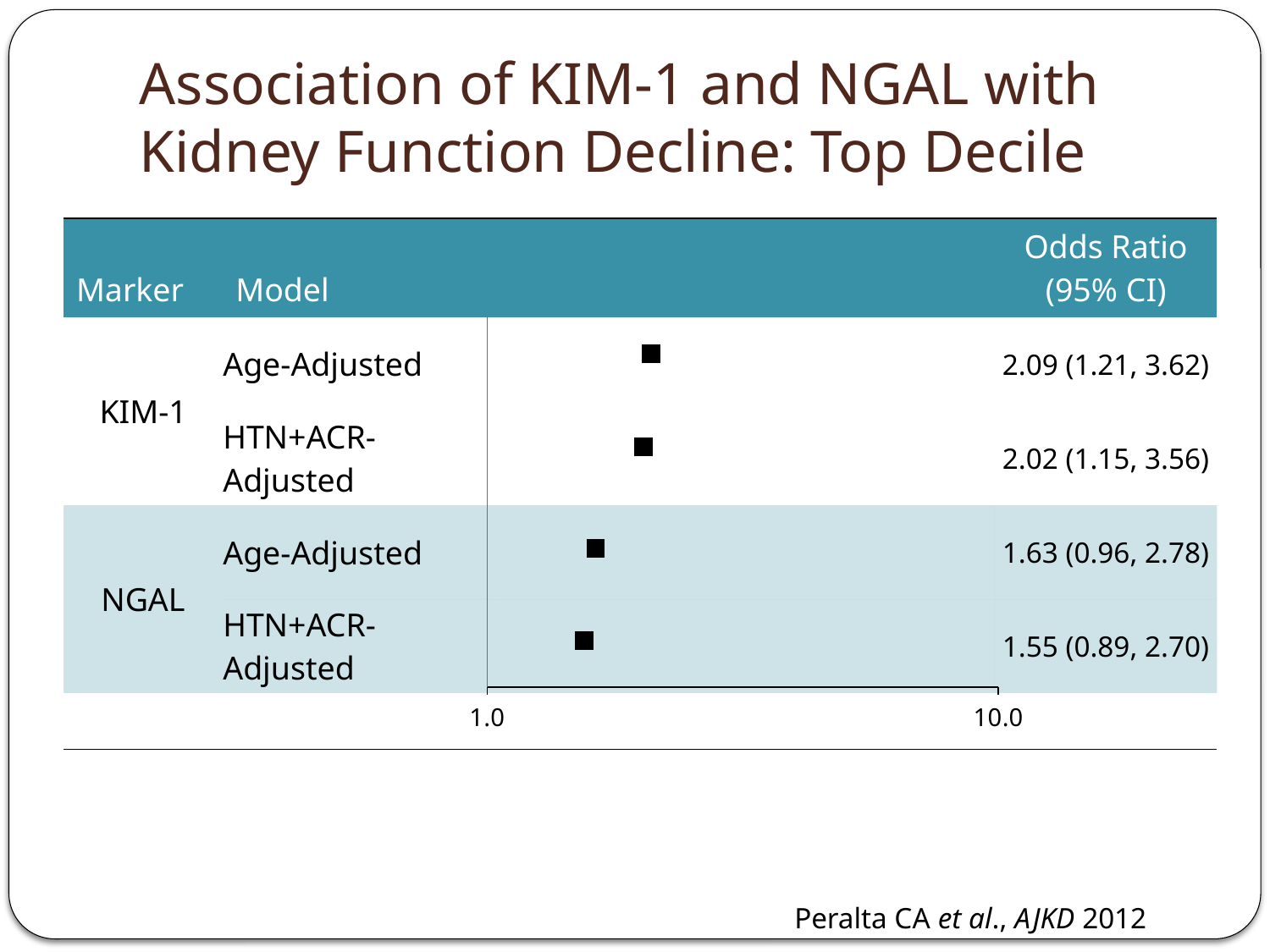
What is the odds ratio and 95% CI for KIM-1 in the HTN+ACR-Adjusted model? 2.02 (1.15, 3.56) Which marker and model has the lowest odds ratio? NGAL, HTN+ACR-Adjusted Which marker and model has the highest odds ratio? KIM-1, Age-Adjusted What are the two tick values shown on the x axis of the plot? 1.0 and 10.0 What is the 95% CI for NGAL in the HTN+ACR-Adjusted model? (0.89, 2.70) What is the odds ratio for NGAL in the Age-Adjusted model? 1.63 What is the difference between the Age-Adjusted odds ratios for KIM-1 and NGAL? 0.46 What is the odds ratio for KIM-1 in the Age-Adjusted model? 2.09 Which has a larger odds ratio: KIM-1 HTN+ACR-Adjusted or NGAL Age-Adjusted? KIM-1 HTN+ACR-Adjusted What is the difference between the Age-Adjusted and HTN+ACR-Adjusted odds ratios for KIM-1? 0.07 Is the odds ratio for NGAL in the HTN+ACR-Adjusted model greater or less than 1.0? greater How many odds ratio points are plotted on the chart? 4